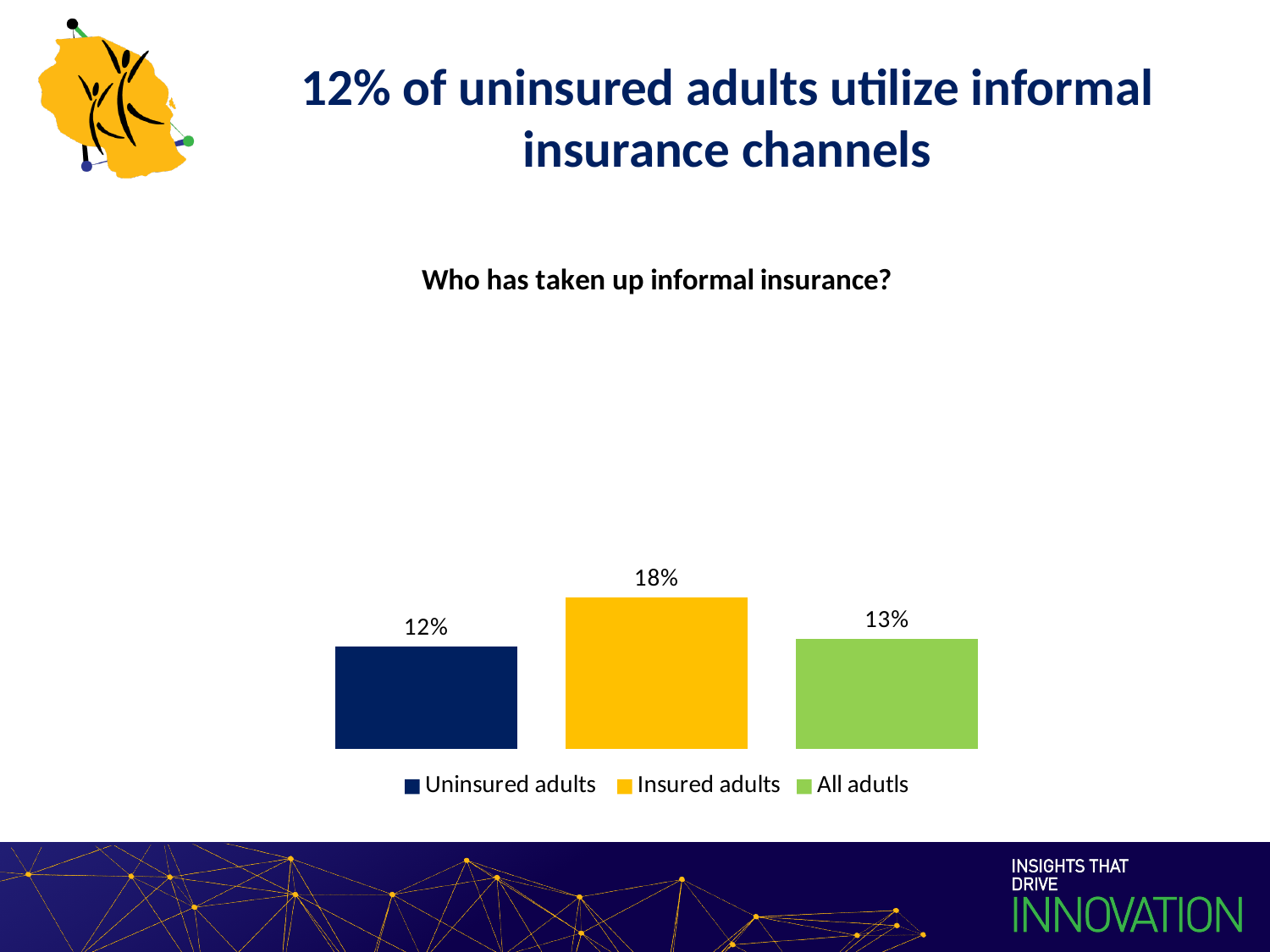
How many bars are shown in the chart? 3 How many entries does the legend list? 3 What type of chart is shown on the slide? Bar chart Which group has the lowest share that has taken up informal insurance? Uninsured adults Which group has the highest share that has taken up informal insurance? Insured adults Which is larger, the value for Insured adults or the value for All adutls? Insured adults What is the value shown for All adutls? 13% What percentage of insured adults have taken up informal insurance? 18% What colour is the bar for Insured adults? Yellow What percentage of uninsured adults have taken up informal insurance? 12% What is the difference between the values for Insured adults and Uninsured adults? 6% What is the difference between the values for All adutls and Uninsured adults? 1%